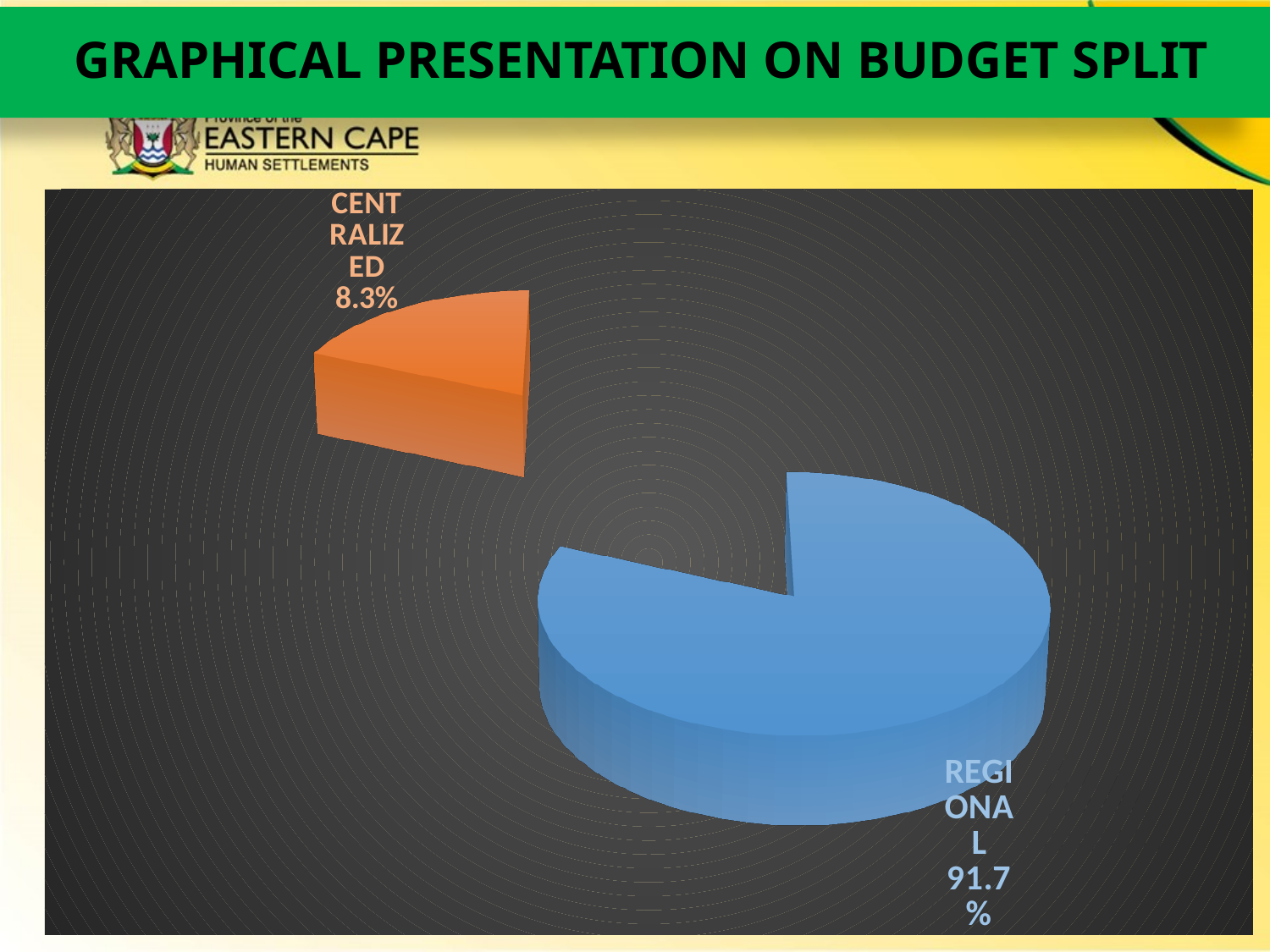
What percentage of the budget is allocated to REGIONAL? 91.7% What kind of chart is shown on the slide? pie chart Which category has the smallest share of the budget? CENTRALIZED Which is larger, the REGIONAL share or the CENTRALIZED share? REGIONAL What percentage of the budget is allocated to CENTRALIZED? 8.3% Which category has the largest share of the budget? REGIONAL How many slices does the pie chart have? 2 What share of the pie does the REGIONAL slice represent? 91.7% What colour is the CENTRALIZED slice? orange What is the difference in percentage points between the REGIONAL and CENTRALIZED shares? 83.4 What is the title of the slide containing the chart? GRAPHICAL PRESENTATION ON BUDGET SPLIT